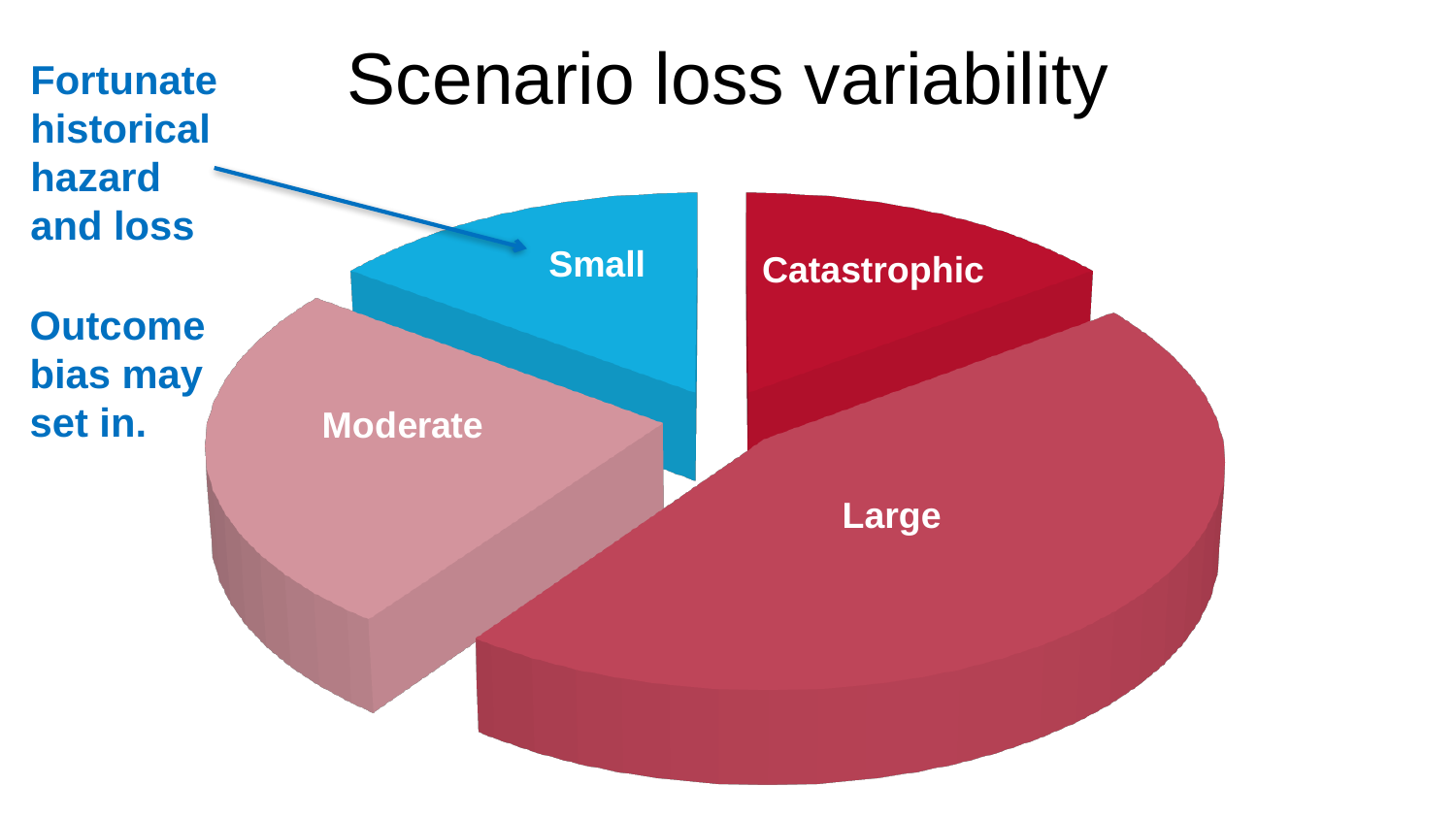
How many slices does the pie chart have? 4 What is the title of the chart? Scenario loss variability What kind of chart is shown on the slide? pie chart Which is larger in the pie chart, the Large slice or the Small slice? Large Which is larger in the pie chart, the Large slice or the Moderate slice? Large Which slice of the pie chart does the arrow labelled "Fortunate historical hazard and loss" point to? Small Which slice of the pie chart is the largest? Large Which is larger in the pie chart, the Moderate slice or the Catastrophic slice? Moderate